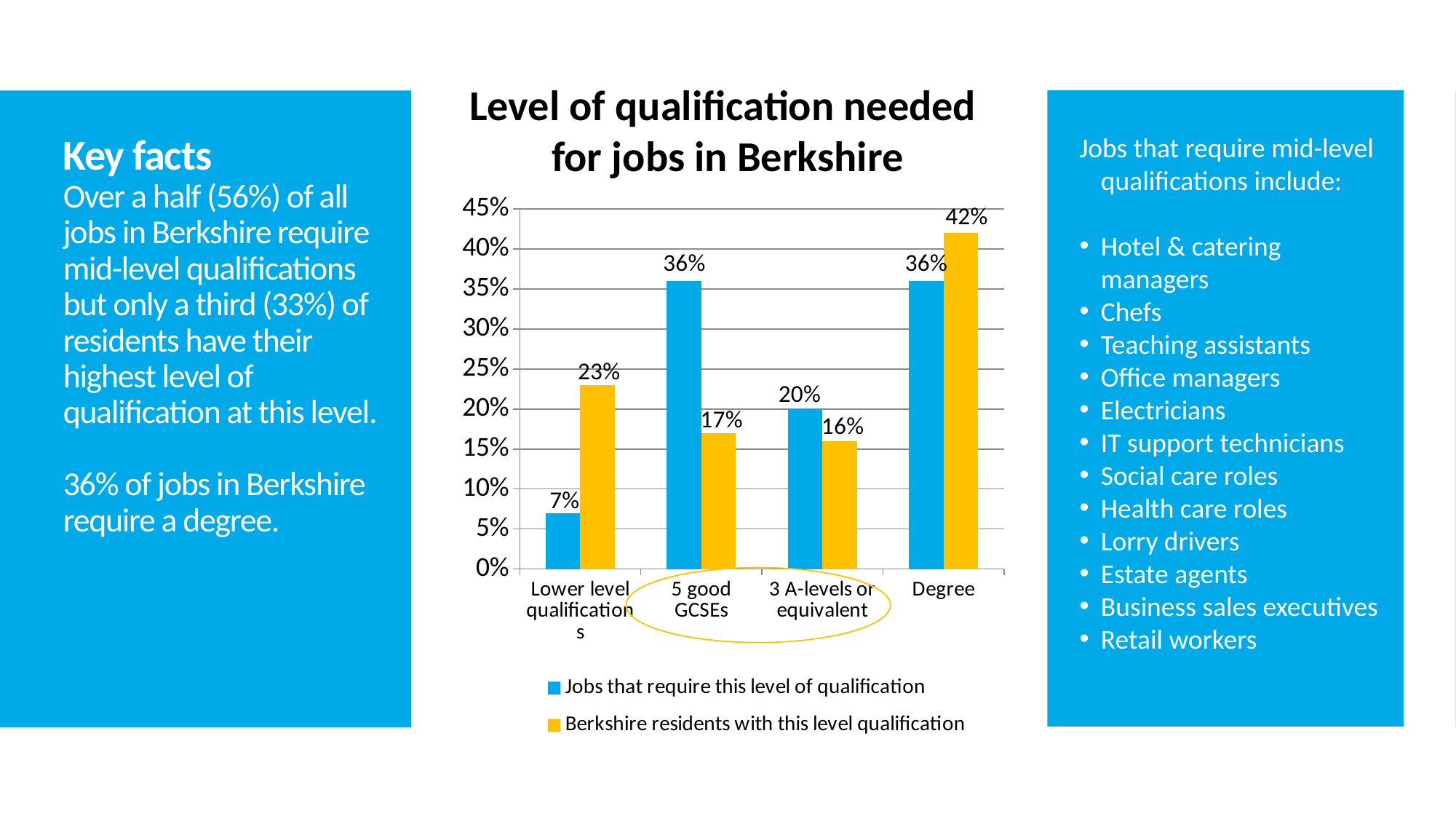
What is the difference between the share of jobs requiring 5 good GCSEs and the share of residents with that qualification? 19% What kind of chart is shown? Bar chart What is the title of the chart? Level of qualification needed for jobs in Berkshire Which qualification level has the lowest share of jobs requiring it? Lower level qualifications What percentage of Berkshire residents have a degree as their highest qualification? 42% For lower level qualifications, which is larger: the share of jobs requiring it or the share of residents with it? Berkshire residents with this level qualification What percentage of jobs require 5 good GCSEs? 36% What percentage of Berkshire residents have 3 A-levels or equivalent as their highest qualification? 16% Which qualification level has the highest share of Berkshire residents? Degree How many series does the legend list? 2 How many qualification levels are shown on the x axis? 4 What percentage of jobs require lower level qualifications? 7%